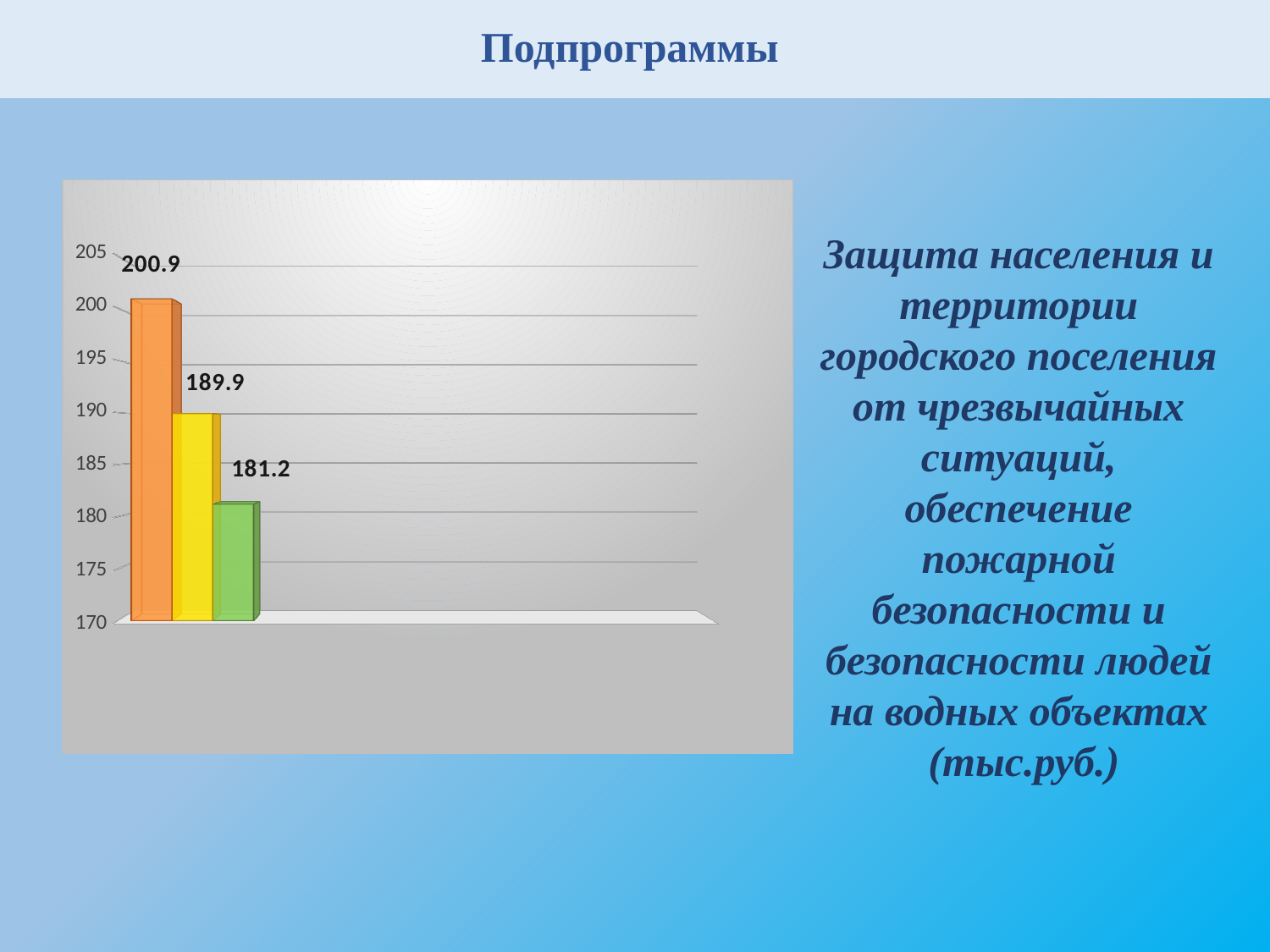
What kind of chart is shown on the slide? bar chart How many bars are plotted in the chart? 3 Is the value of the green bar greater or less than 185? less What is the highest value shown in the chart? 200.9 What value is shown on the green bar in the chart? 181.2 What is the difference between the orange bar (200.9) and the yellow bar (189.9)? 11 What value is shown on the orange bar in the chart? 200.9 What is the difference between the orange bar (200.9) and the green bar (181.2)? 19.7 What is the lowest value shown in the chart? 181.2 Which bar is taller, the yellow bar or the green bar? the yellow bar Do the bar values rise or fall from left to right across the chart? fall What value is shown on the yellow bar in the chart? 189.9